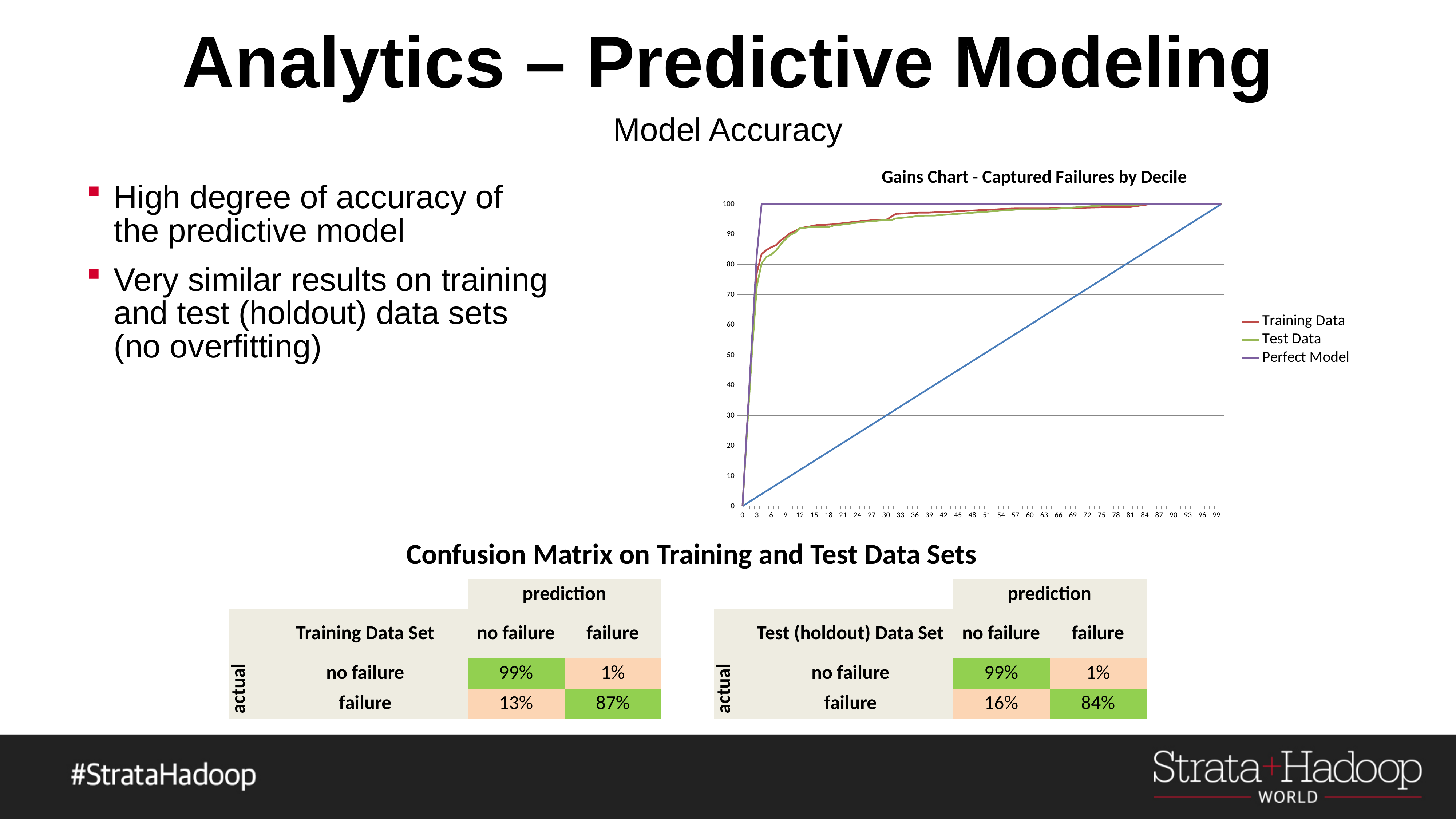
Which series are listed in the legend of the Gains Chart? Training Data, Test Data, Perfect Model What is the title of the chart on the slide? Gains Chart - Captured Failures by Decile What type of chart is the Gains Chart - Captured Failures by Decile? line chart In the Gains Chart, is the Perfect Model value at x = 6 greater or less than 90? greater What is the last tick label shown on the x axis of the Gains Chart? 99 In the Gains Chart, which series reaches 100 earliest along the x axis? Perfect Model In the Gains Chart, which series is higher at x = 12, Perfect Model or Training Data? Perfect Model In the Gains Chart, does the Training Data line rise or fall as the x axis increases? rise How many series does the legend of the Gains Chart list? 3 What is the highest tick value shown on the y axis of the Gains Chart? 100 In the Gains Chart, is the Training Data value at x = 12 greater or less than 80? greater